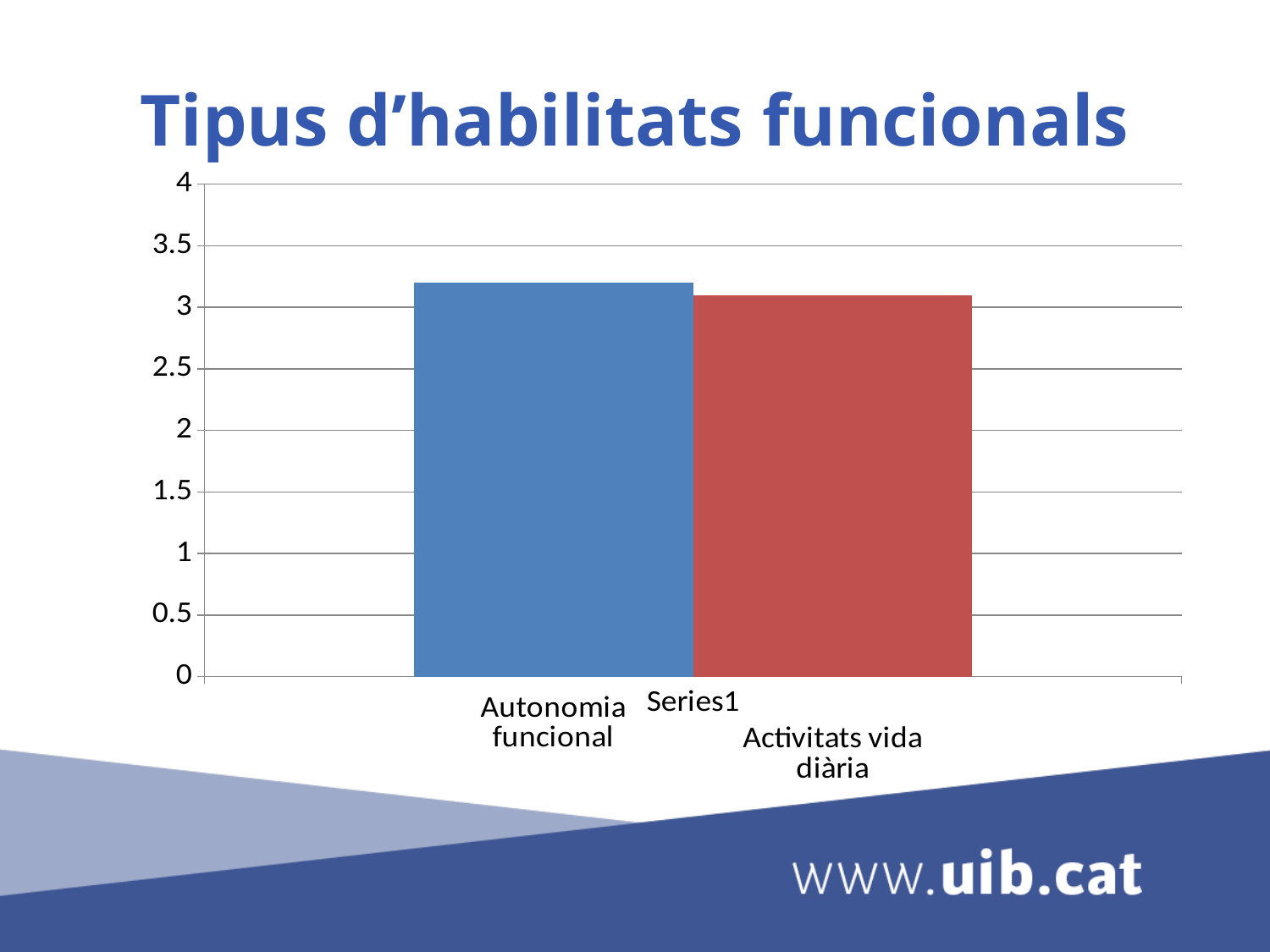
What is the highest value shown on the vertical axis? 4 Is the value for Autonomia funcional greater or less than 3.5? less How many bars are plotted in the chart? 2 What kind of chart is shown on the slide? bar chart Is the value for Activitats vida diària greater or less than 2.5? greater Which category has the lowest bar? Activitats vida diària Is the value for Autonomia funcional greater or less than 3? greater Which category has the highest bar? Autonomia funcional Which is larger, the value for Autonomia funcional or the value for Activitats vida diària? Autonomia funcional What is the title of the chart? Tipus d'habilitats funcionals